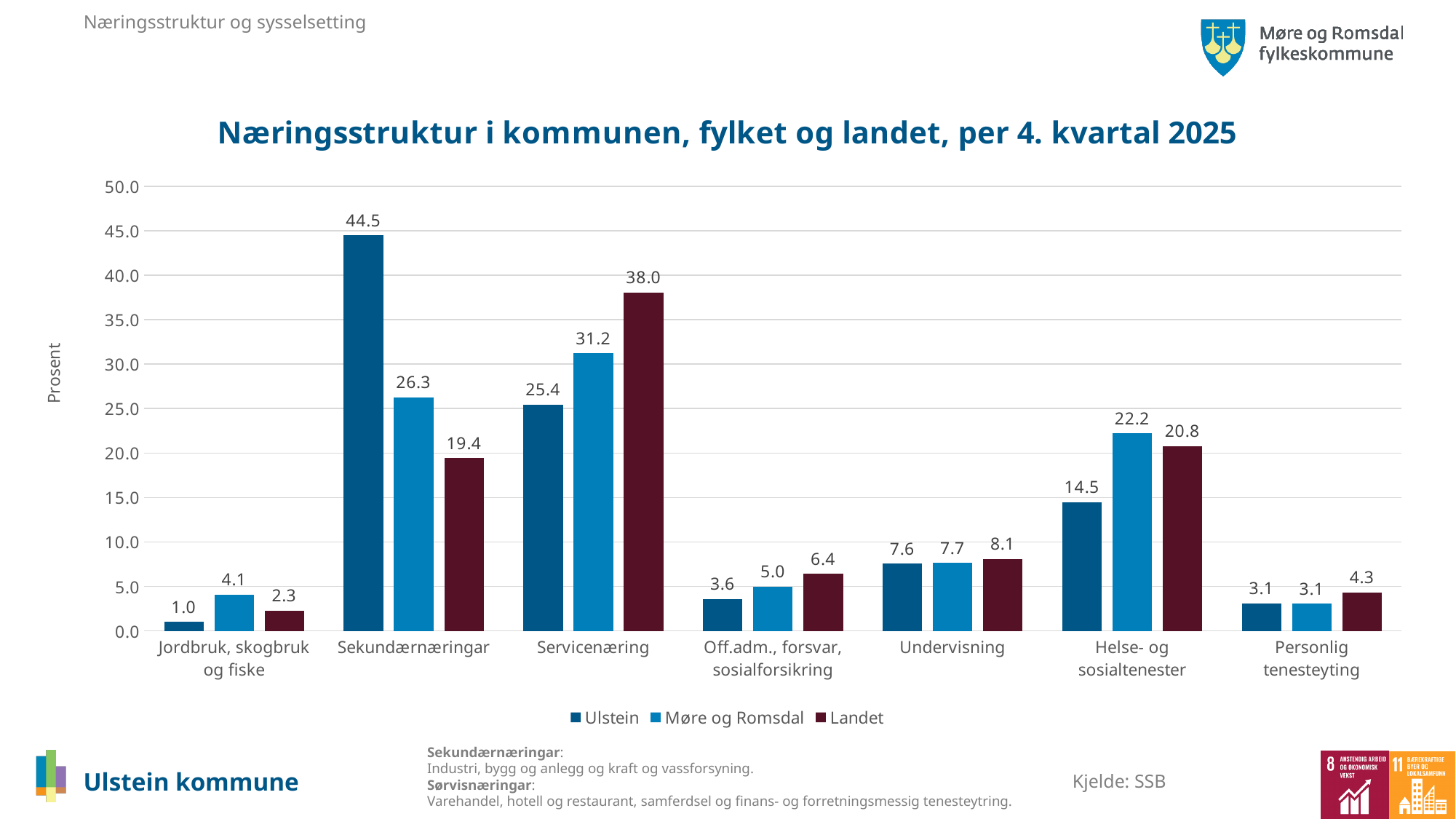
How many series does the legend list? 3 What is the difference between the Ulstein and Landet values in Sekundærnæringar? 25.1 Which category has the highest value for Ulstein? Sekundærnæringar What is the value for Ulstein in Sekundærnæringar? 44.5 What kind of chart is shown? bar chart Is the value for Landet in Helse- og sosialtenester greater or less than 25.0? less What is the title of the chart? Næringsstruktur i kommunen, fylket og landet, per 4. kvartal 2025 How many categories are shown on the x axis? 7 Which category has the lowest value for Landet? Jordbruk, skogbruk og fiske What is the value for Møre og Romsdal in Helse- og sosialtenester? 22.2 Which is larger in Servicenæring: the value for Ulstein or for Møre og Romsdal? Møre og Romsdal What is the value for Landet in Servicenæring? 38.0